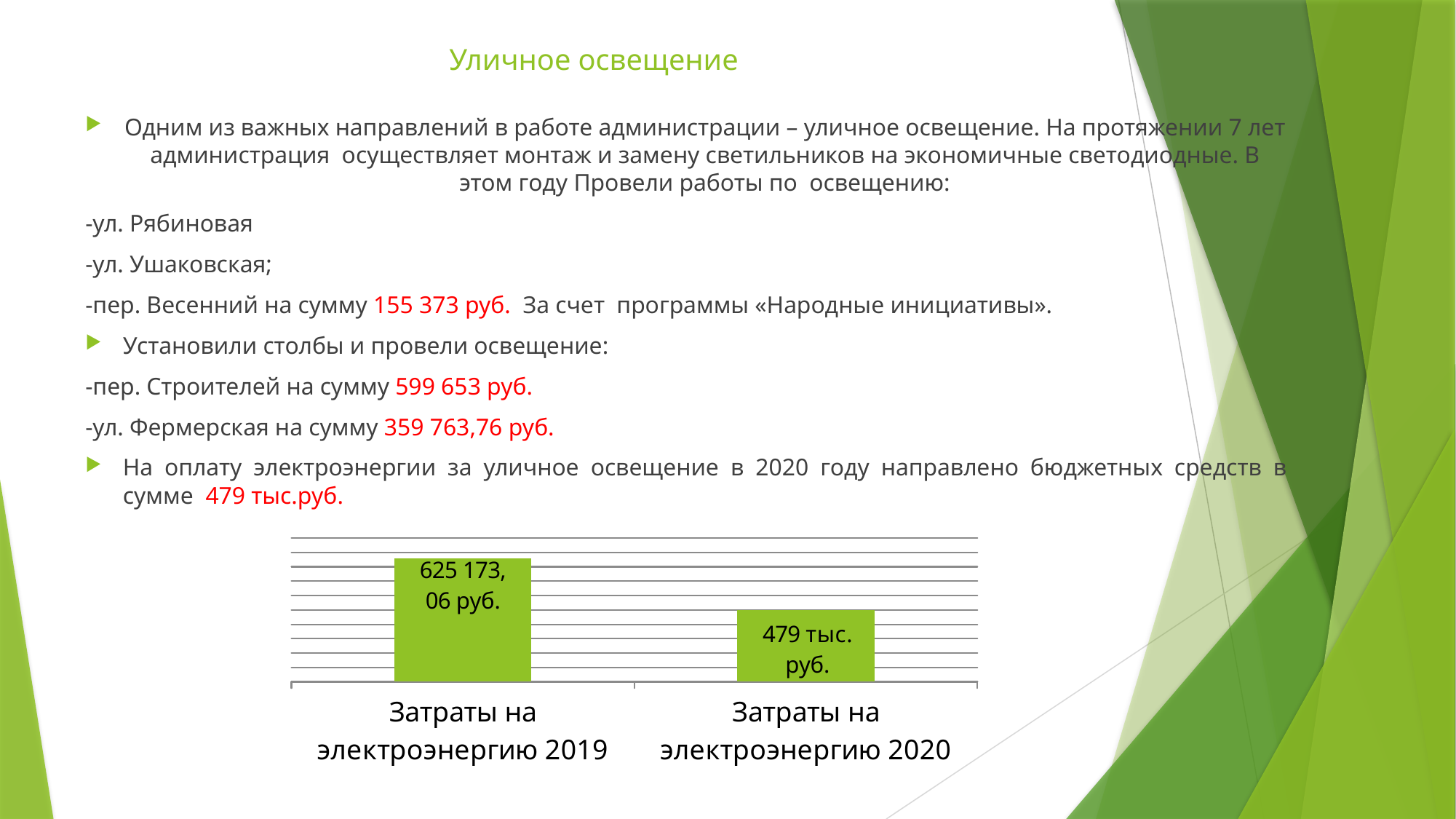
Which category has the lowest bar? Затраты на электроэнергию 2020 What kind of chart is shown on the slide? bar chart Which category has the highest bar? Затраты на электроэнергию 2019 What is the value shown for Затраты на электроэнергию 2019? 625 173,06 руб. What colour are the bars in the chart? green What is the label of the first category on the x axis? Затраты на электроэнергию 2019 What is the value shown for Затраты на электроэнергию 2020? 479 тыс. руб. Which is larger, the bar for Затраты на электроэнергию 2019 or the bar for Затраты на электроэнергию 2020? Затраты на электроэнергию 2019 Do the values rise or fall from 2019 to 2020 along the x axis? fall How many bars are plotted in the chart? 2